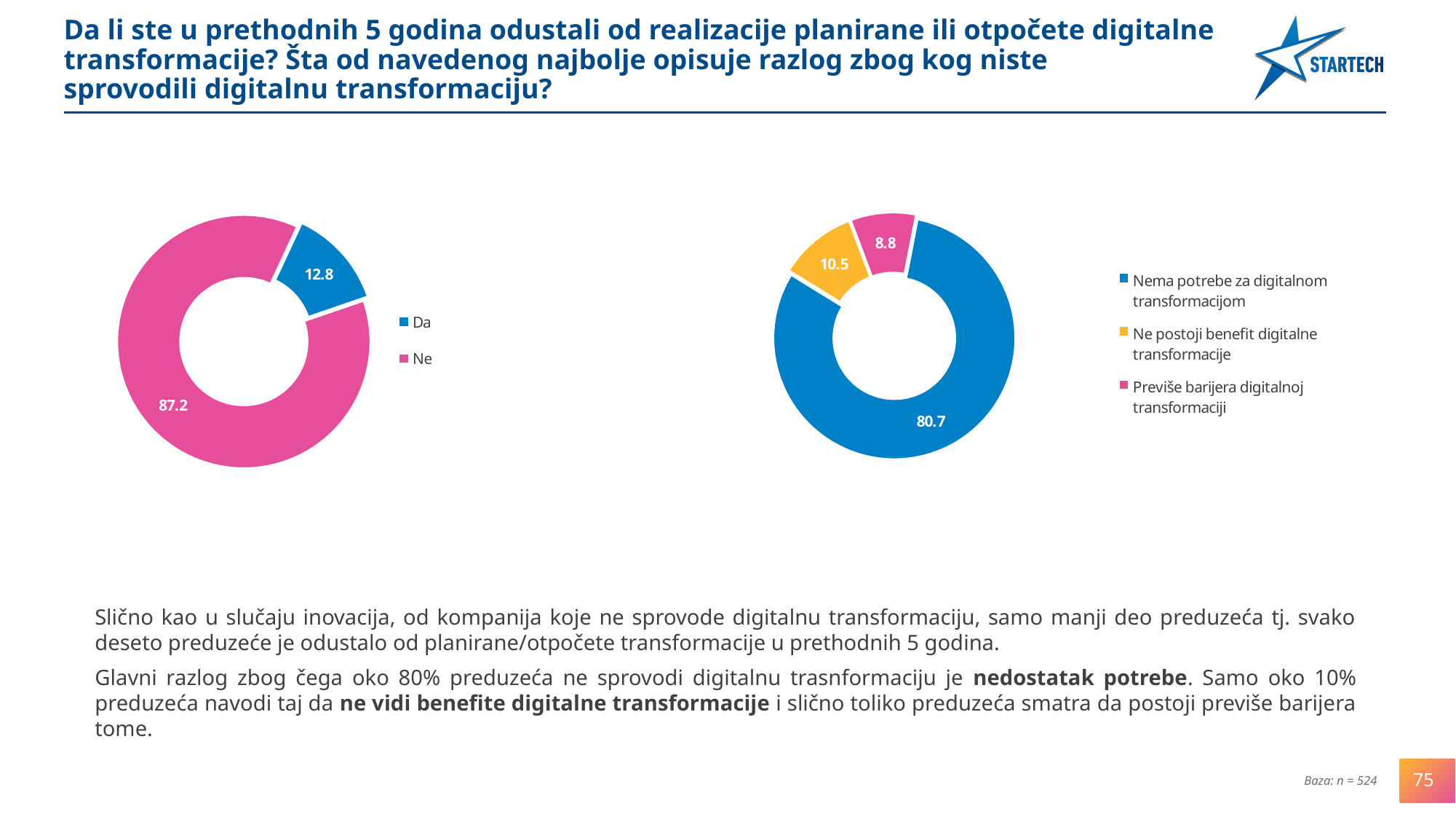
What type of chart is the left chart on the slide? Doughnut chart In the left doughnut chart, what is the value for "Ne"? 87.2 In the right doughnut chart, what is the value for "Previše barijera digitalnoj transformaciji"? 8.8 In the left doughnut chart, how many categories are shown? 2 In the right doughnut chart, what is the value for "Ne postoji benefit digitalne transformacije"? 10.5 In the right doughnut chart, what is the value for "Nema potrebe za digitalnom transformacijom"? 80.7 In the right doughnut chart, how many entries does the legend list? 3 In the left doughnut chart, which category has the largest share? Ne In the right doughnut chart, which category has the smallest share? Previše barijera digitalnoj transformaciji In the left doughnut chart, what is the difference between the values for "Ne" and "Da"? 74.4 In the left doughnut chart, what is the value for "Da"? 12.8 In the right doughnut chart, which is larger: "Ne postoji benefit digitalne transformacije" or "Previše barijera digitalnoj transformaciji"? Ne postoji benefit digitalne transformacije